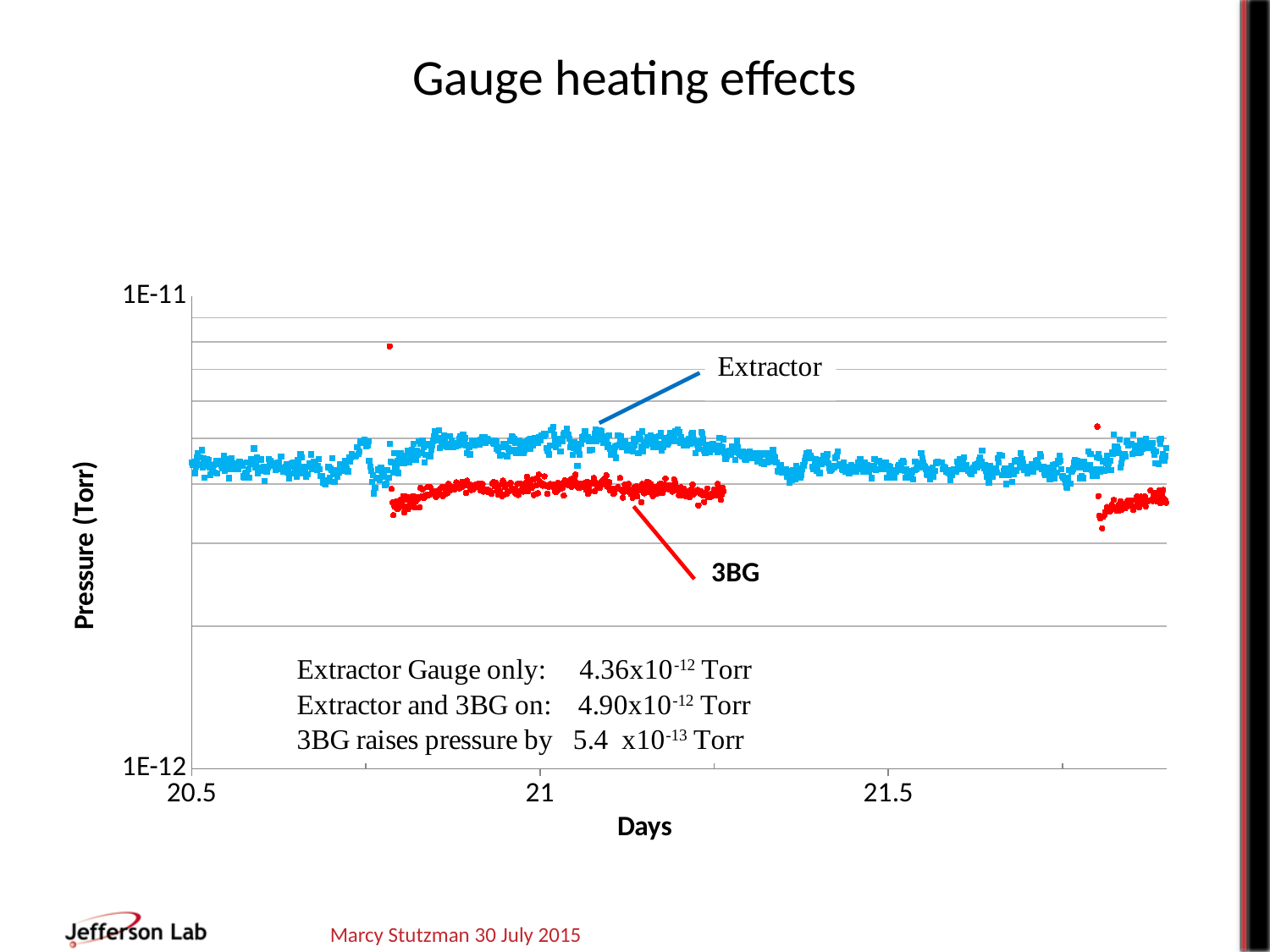
What is the title of the chart on the slide? Gauge heating effects According to the annotation, what is the pressure with the Extractor Gauge only? 4.36x10^-12 Torr What is the label of the x axis? Days What are the names of the two series labelled on the chart? Extractor and 3BG Which series shows higher pressure values, Extractor or 3BG? Extractor By how much does the 3BG raise the pressure, according to the annotation? 5.4 x10^-13 Torr What type of chart is shown on the slide? Scatter chart What is the label of the y axis? Pressure (Torr) How many data series are plotted on the chart? 2 What is the lowest value shown on the y axis? 1E-12 Are the Extractor pressure values greater or less than 1E-11 Torr? less According to the annotation, what is the pressure with the Extractor and 3BG on? 4.90x10^-12 Torr